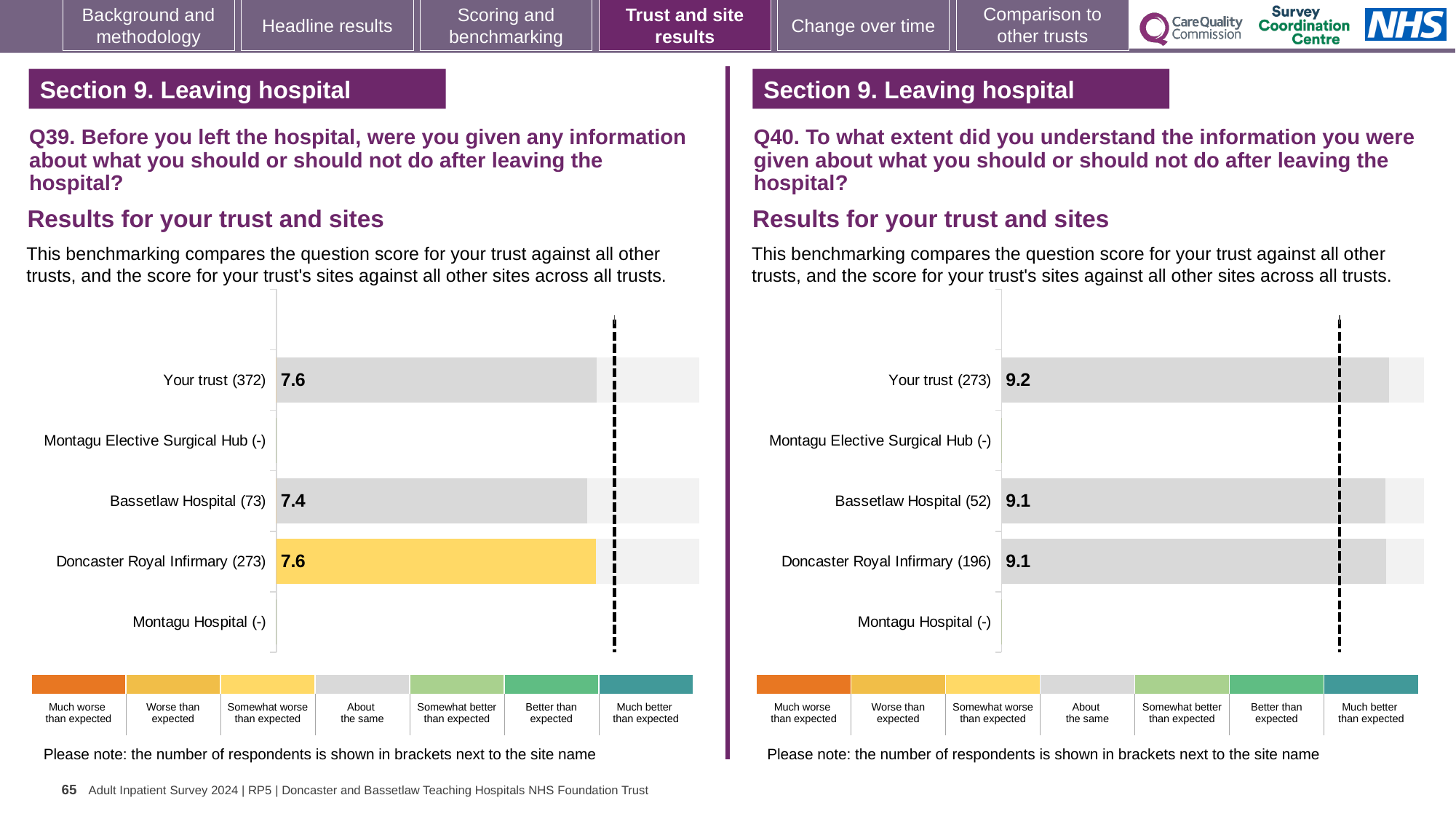
What kind of chart is used for the Q39 results on the left? Bar chart In the Q39 chart on the left, what is the score for Bassetlaw Hospital? 7.4 In the Q40 chart on the right, which row has the highest score? Your trust In the Q39 chart on the left, what is the score for Doncaster Royal Infirmary? 7.6 In the Q39 chart on the left, which site has the lowest score among those with a plotted bar? Bassetlaw Hospital How many rows (trust and sites) are listed on the y axis of the Q40 chart on the right? 5 In the Q39 chart on the left, what is the score for Your trust? 7.6 In the Q40 chart on the right, what is the score for Your trust? 9.2 In the Q40 chart on the right, what is the difference between the scores for Your trust and Bassetlaw Hospital? 0.1 In the Q40 chart on the right, what is the score for Doncaster Royal Infirmary? 9.1 In the Q39 chart on the left, what is the difference between the scores for Doncaster Royal Infirmary and Bassetlaw Hospital? 0.2 In the Q39 chart on the left, how many respondents are shown in brackets for Your trust? 372